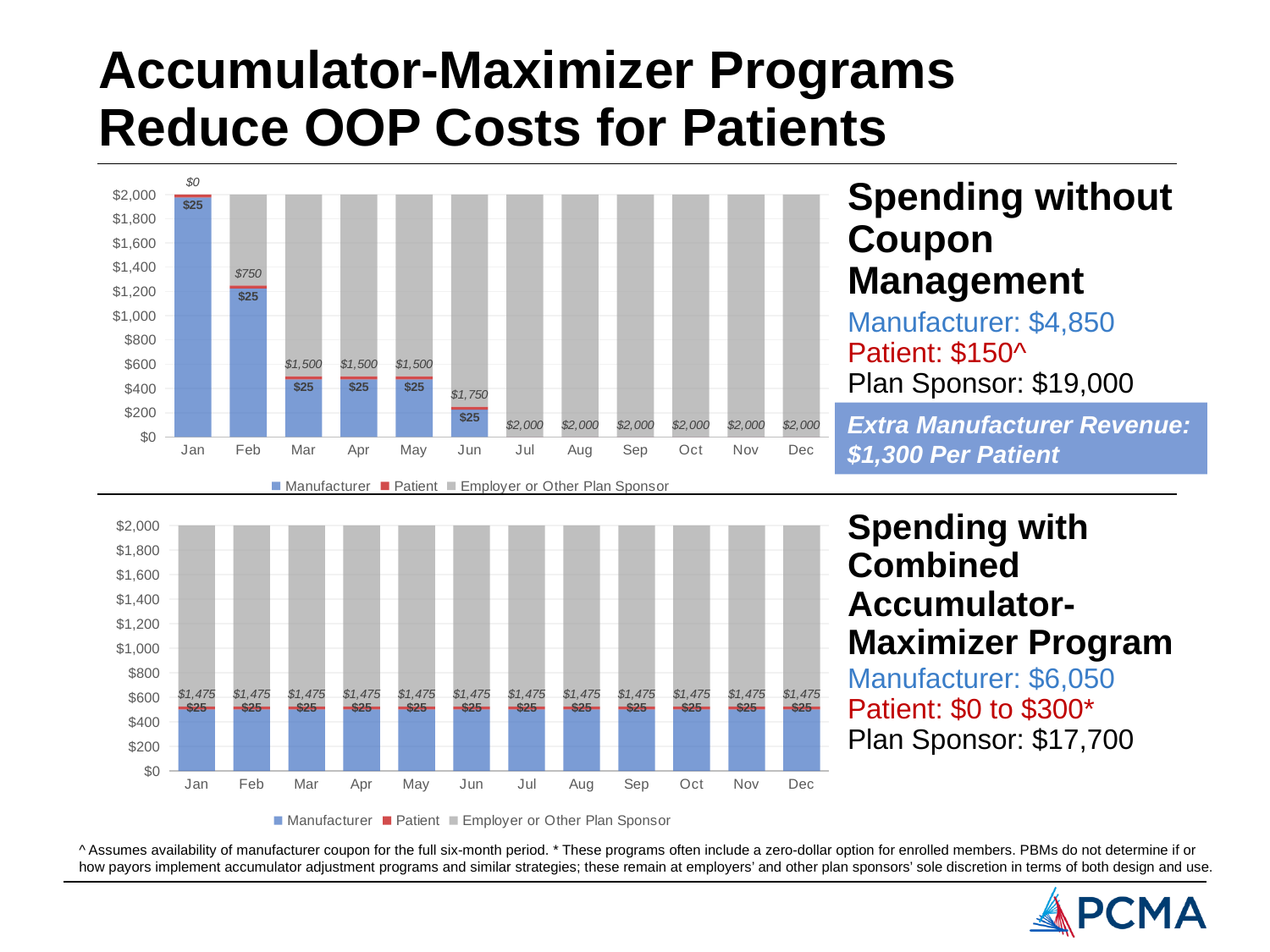
In the top chart (Spending without Coupon Management), which month has the lowest Employer or Other Plan Sponsor value? Jan In the top chart (Spending without Coupon Management), what is the Patient value for Mar? $25 In the top chart (Spending without Coupon Management), what is the difference between the Employer or Other Plan Sponsor values for Jun and Feb? $1,000 In the top chart (Spending without Coupon Management), does the Employer or Other Plan Sponsor value rise or fall from Jan to Dec? rise In the bottom chart (Spending with Combined Accumulator-Maximizer Program), what is the difference between the Employer or Other Plan Sponsor value and the Patient value for Jan? $1,450 In the bottom chart (Spending with Combined Accumulator-Maximizer Program), what is the Employer or Other Plan Sponsor value for Sep? $1,475 In the top chart (Spending without Coupon Management), is the Manufacturer value for Jan greater or less than $1,800? greater In the top chart (Spending without Coupon Management), is the Employer or Other Plan Sponsor value larger in Mar or in Jul? Jul How many series does the legend of the top chart (Spending without Coupon Management) list? 3 In the top chart (Spending without Coupon Management), what is the Employer or Other Plan Sponsor value for Jun? $1,750 In the top chart (Spending without Coupon Management), what is the Employer or Other Plan Sponsor value for Feb? $750 How many months are shown on the x axis of the bottom chart (Spending with Combined Accumulator-Maximizer Program)? 12